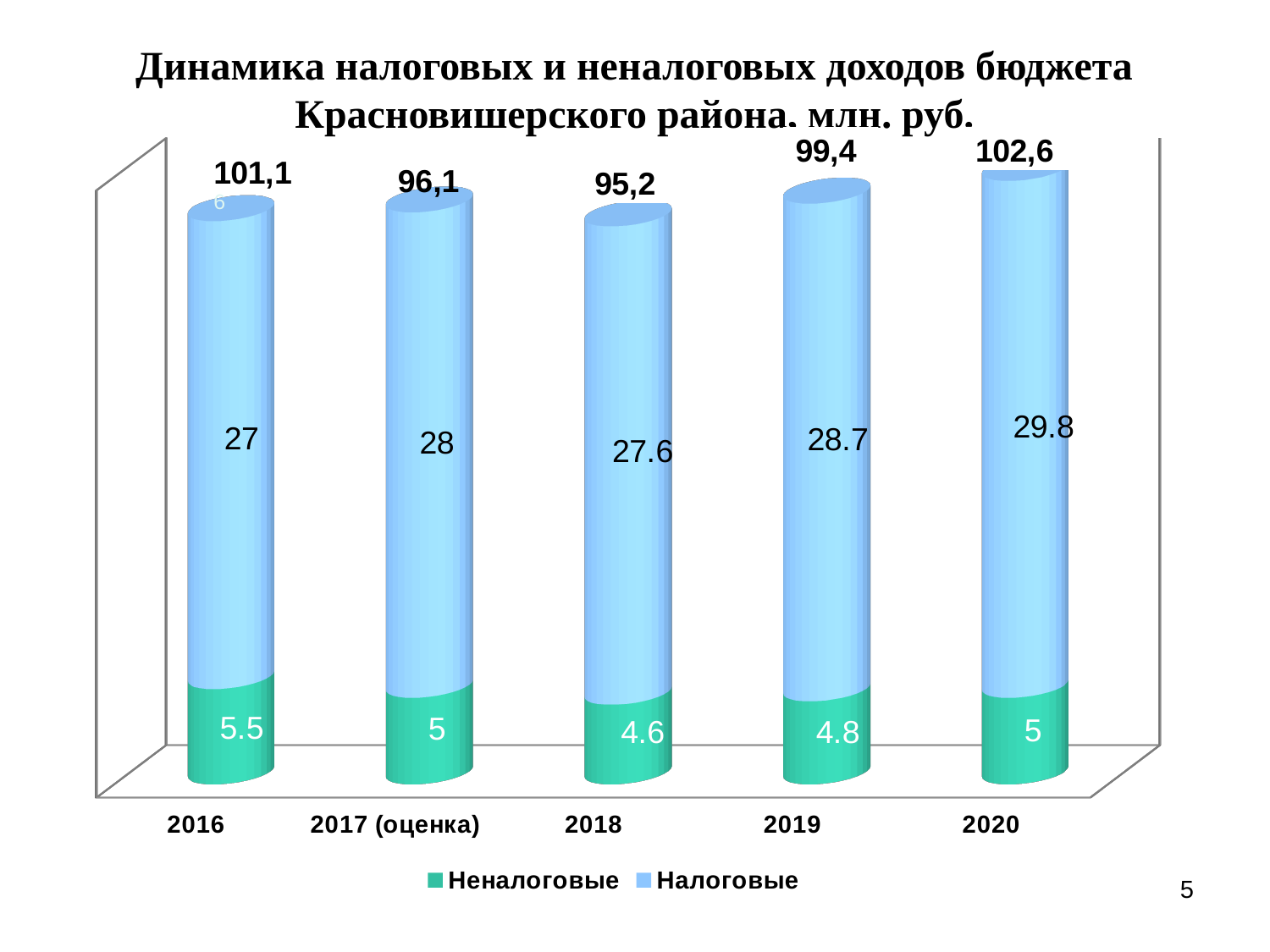
What is the total of the stacked bar for 2020 (Неналоговые plus Налоговые)? 34.8 How many series does the legend list? 2 Which is larger, the Налоговые value for 2019 or for 2018? 2019 What kind of chart is shown on the slide? stacked bar chart How many years (categories) are shown on the x axis? 5 What is the value of Налоговые for 2020? 29.8 What is the value of Неналоговые for 2018? 4.6 In which year is the Неналоговые value lowest? 2018 What is the difference between the Налоговые values for 2020 and 2016? 2.8 Which series is shown in green in the legend? Неналоговые In which year is the Налоговые value highest? 2020 What is the value of Неналоговые for 2017 (оценка)? 5